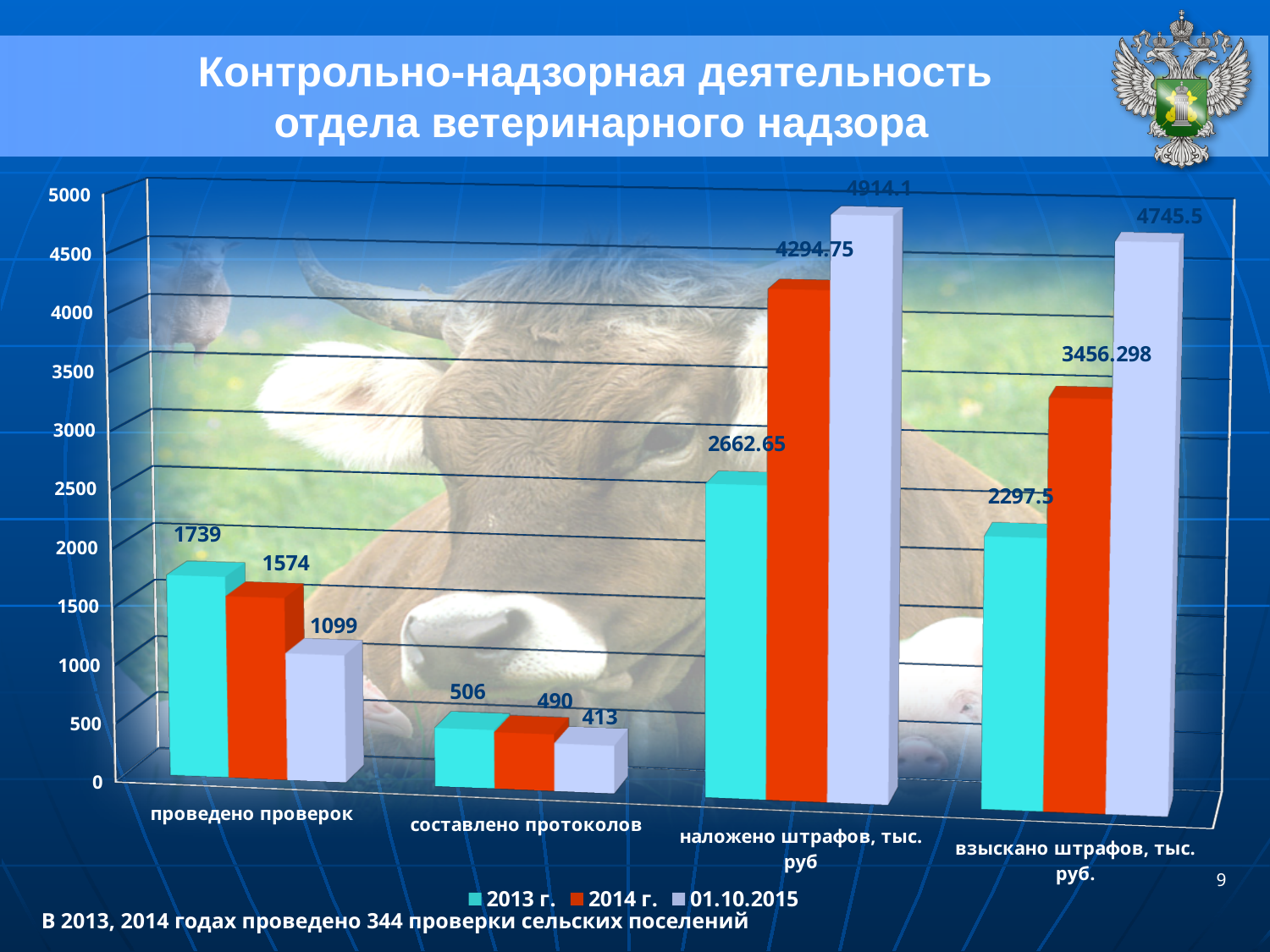
How many series does the legend list? 3 Which category has the lowest value in the 2013 г. series? составлено протоколов What is the value for "наложено штрафов, тыс. руб" in the 2014 г. series? 4294.75 How many categories are shown on the x axis? 4 Which is larger for "взыскано штрафов, тыс. руб.": the 2013 г. value or the 2014 г. value? 2014 г. What kind of chart is shown on the slide? bar chart What is the difference between the 2013 г. and 01.10.2015 values for "проведено проверок"? 640 What is the value for "взыскано штрафов, тыс. руб." in the 01.10.2015 series? 4745.5 What is the value for "проведено проверок" in the 2013 г. series? 1739 Is the 2014 г. value for "взыскано штрафов, тыс. руб." greater or less than 3000? greater What is the value for "составлено протоколов" in the 01.10.2015 series? 413 Which category has the highest value in the 01.10.2015 series? наложено штрафов, тыс. руб